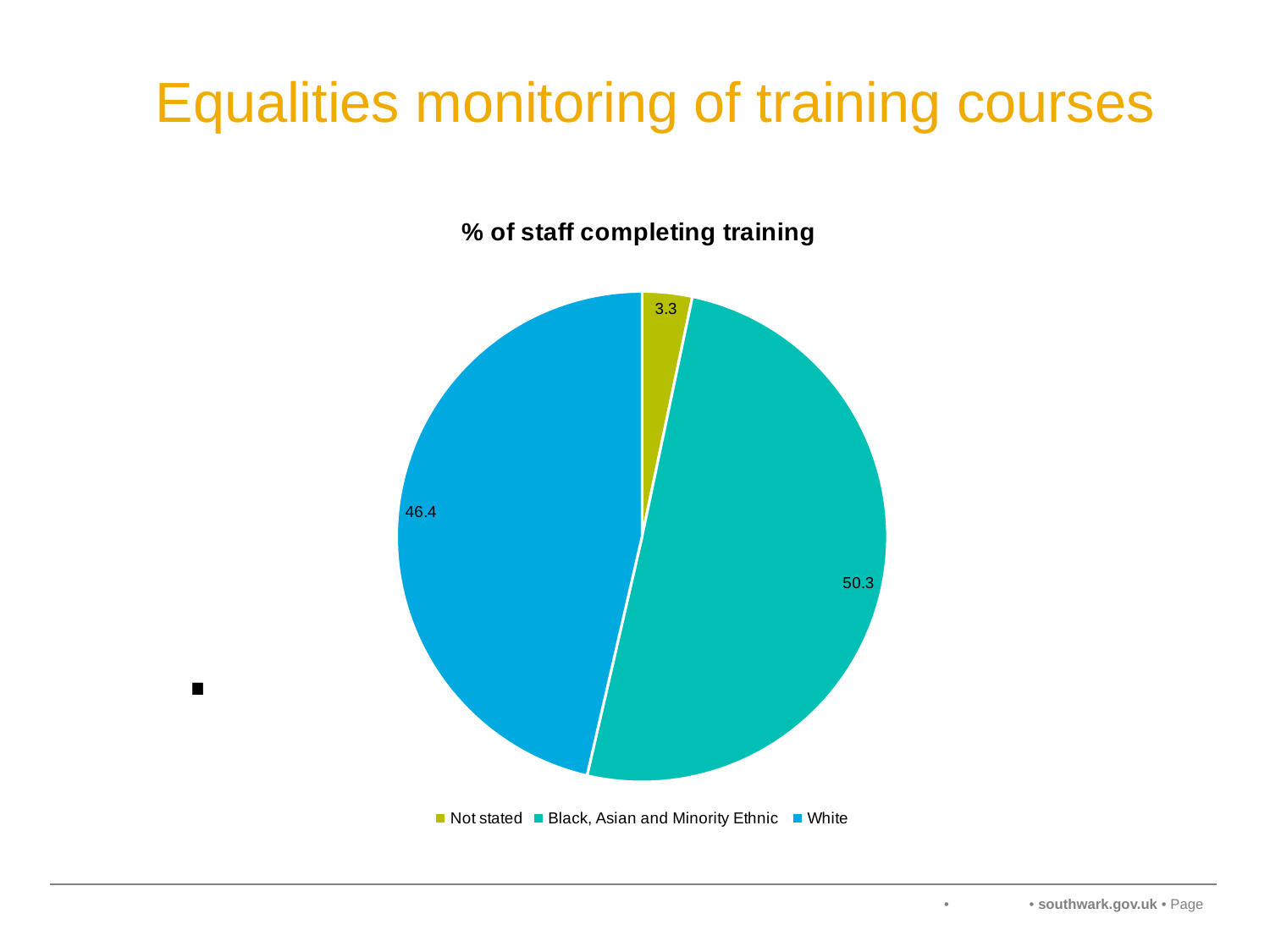
Which category has the largest slice? Black, Asian and Minority Ethnic What kind of chart is shown on the slide? pie chart What is the value for the Black, Asian and Minority Ethnic slice? 50.3 What is the value for the Not stated slice? 3.3 What is the difference between the White value and the Not stated value? 43.1 What is the title of the chart? % of staff completing training Which category has the smallest slice? Not stated What is the value for the White slice? 46.4 How many entries does the legend list? 3 Which is larger, the White slice or the Not stated slice? White How many slices does the pie chart have? 3 What is the difference between the Black, Asian and Minority Ethnic value and the White value? 3.9